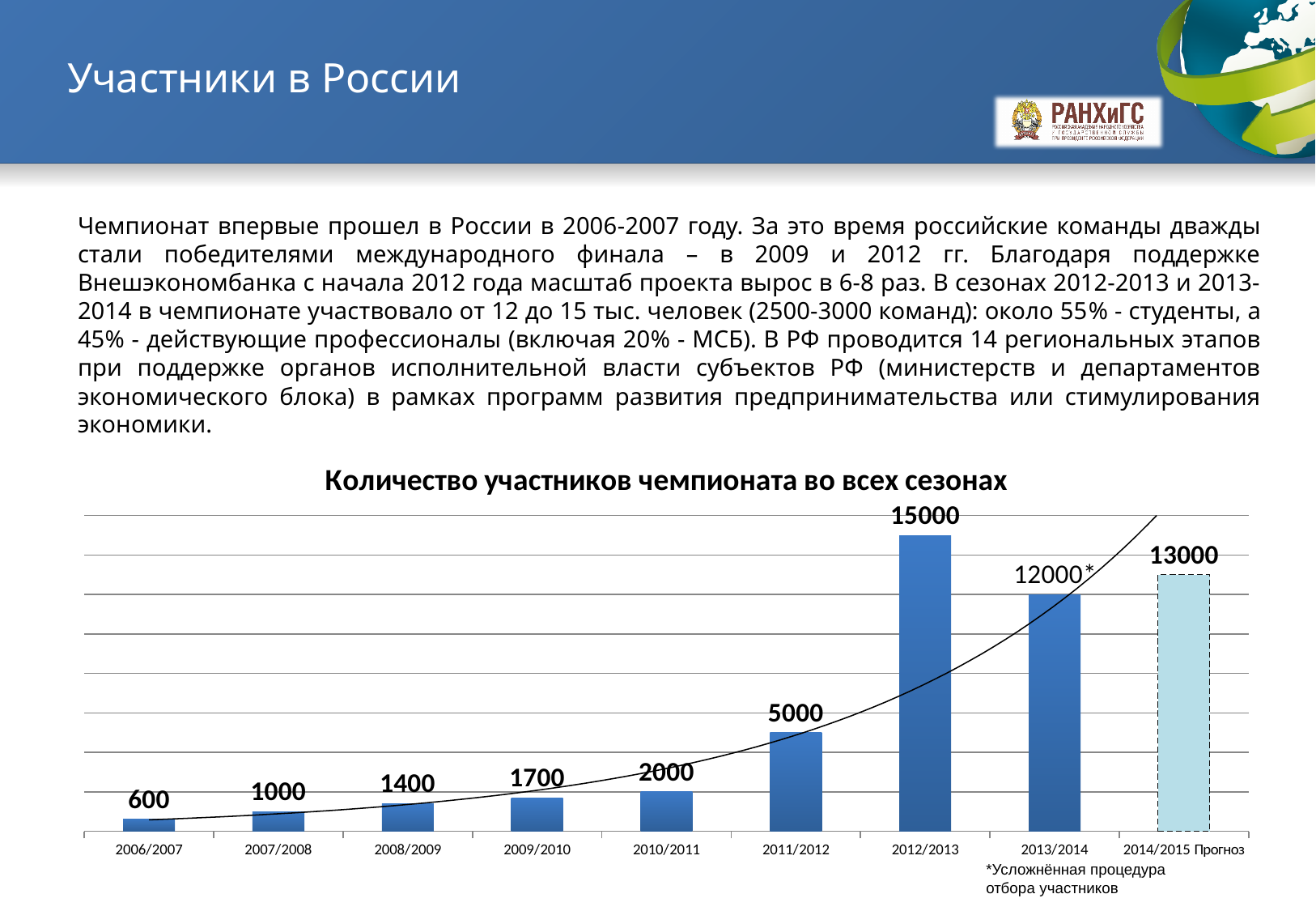
What is the number of participants shown for the 2006/2007 season? 600 What is the number of participants shown for the 2011/2012 season? 5000 What kind of chart is used to show the number of participants? Bar chart What is the difference in participants between the 2011/2012 and 2010/2011 seasons? 3000 What is the number of participants shown for the 2012/2013 season? 15000 What is the title of the chart? Количество участников чемпионата во всех сезонах How many seasons (categories) are shown on the chart? 9 What is the forecast number of participants for 2014/2015 (Прогноз)? 13000 Which season has the lowest number of participants? 2006/2007 Which season has the highest number of participants? 2012/2013 What is the difference in participants between the 2012/2013 and 2013/2014 seasons? 3000 Which season has more participants, 2013/2014 or 2014/2015 Прогноз? 2014/2015 Прогноз